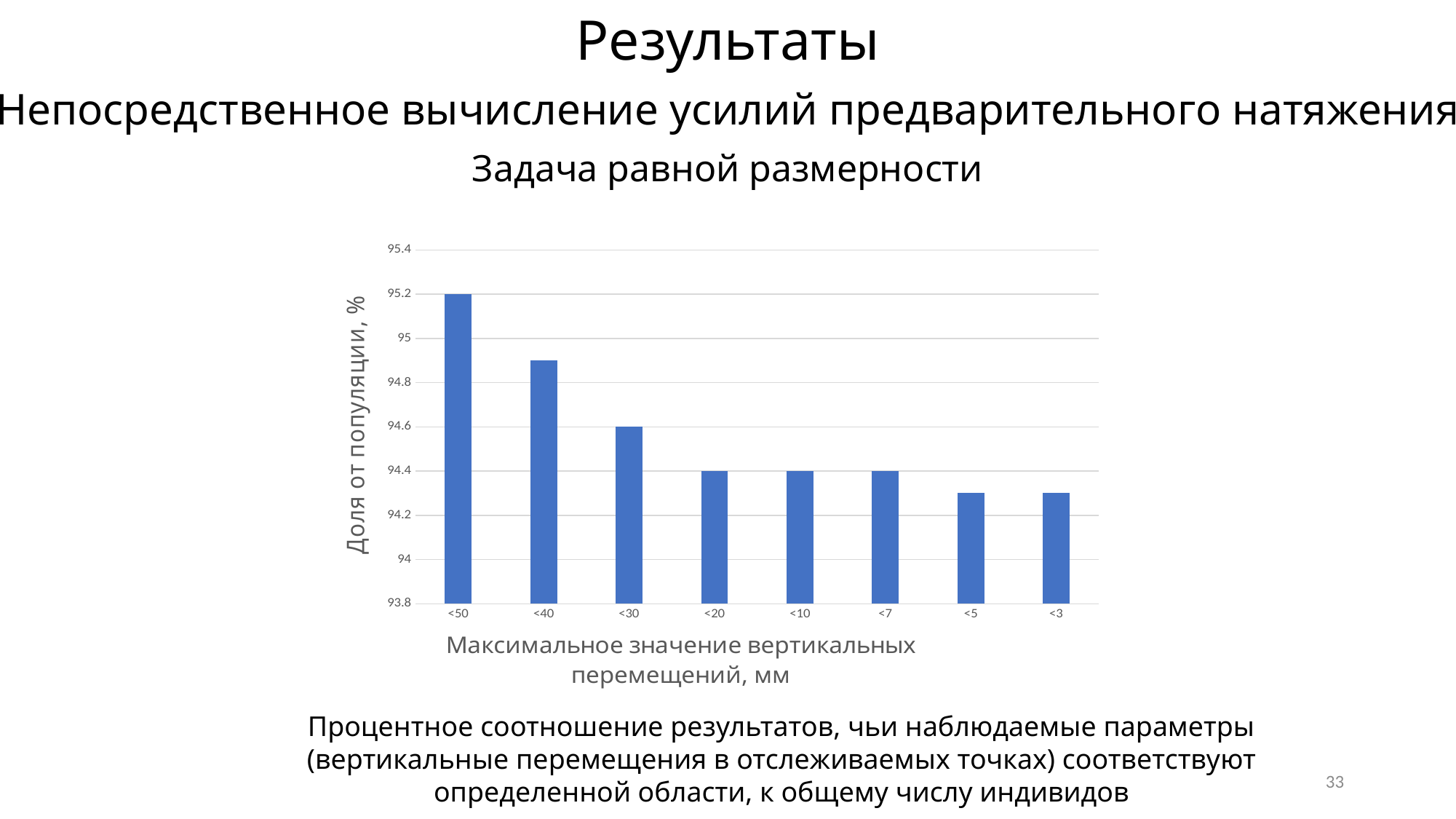
What is the value for the category <50? 95.2 Is the value for <40 greater or less than 94.8? greater Is the value for <5 greater or less than 94.4? less What type of chart is shown on the slide? Bar chart Which is larger, the value for <50 or the value for <40? <50 What is the value for the category <20? 94.4 How many categories are shown on the x axis of the chart? 8 What is the difference between the values for <50 and <30? 0.6 What is the value for the category <30? 94.6 Which category has the highest value? <50 What is the title of the vertical axis of the chart? Доля от популяции, % Do the values rise or fall moving from <50 to <3 along the x axis? Fall